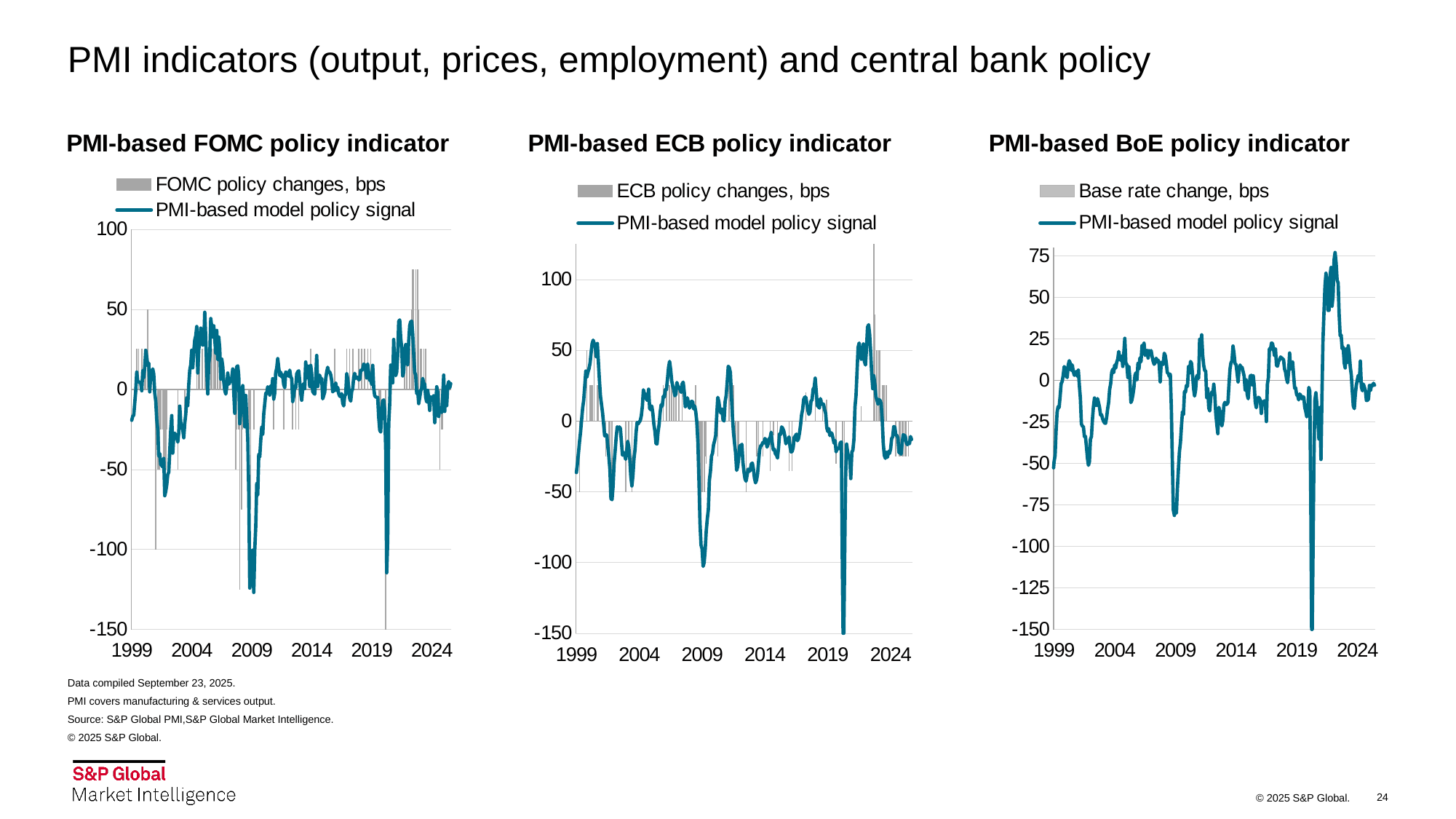
In the PMI-based FOMC policy indicator chart, how many series does the legend list? 2 In the PMI-based BoE policy indicator chart, what is the name of the bar series in the legend? Base rate change, bps In the PMI-based BoE policy indicator chart, is the peak of the PMI-based model policy signal around 2022 greater or less than 50? greater In the PMI-based FOMC policy indicator chart, is the lowest value of the PMI-based model policy signal around 2009 greater or less than -100? less In the PMI-based ECB policy indicator chart, is the peak of the PMI-based model policy signal around 2022 greater or less than 50? greater In the PMI-based BoE policy indicator chart, does the PMI-based model policy signal rise or fall between 2022 and 2024? fall What kind of chart is the PMI-based FOMC policy indicator? Combined bar and line chart How many charts are shown on the slide? 3 How many year labels are shown on the x axis of the PMI-based FOMC policy indicator chart? 6 In the PMI-based ECB policy indicator chart, what is the name of the bar series in the legend? ECB policy changes, bps